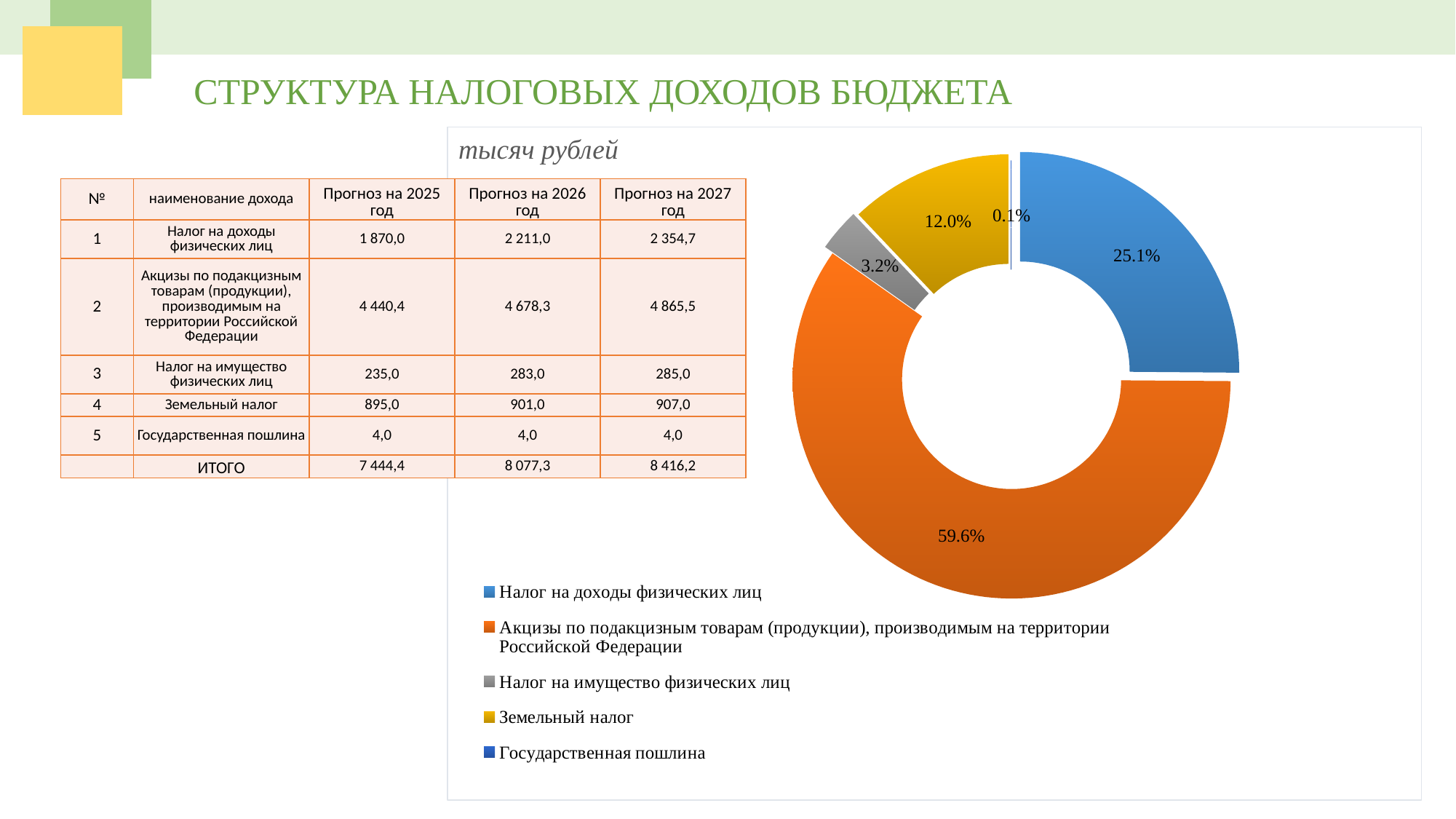
Which category has the smallest share in the doughnut chart? Государственная пошлина In the doughnut chart, what is the difference in percentage points between the share of "Акцизы по подакцизным товарам" and "Налог на доходы физических лиц"? 34.5 percentage points What share of the doughnut chart does "Государственная пошлина" have? 0.1% What share of the doughnut chart does "Акцизы по подакцизным товарам (продукции), производимым на территории Российской Федерации" have? 59.6% What kind of chart is shown on the slide? Doughnut (pie) chart In the doughnut chart, which is larger: the share of "Земельный налог" or "Налог на имущество физических лиц"? Земельный налог Which category has the largest share in the doughnut chart? Акцизы по подакцизным товарам (продукции), производимым на территории Российской Федерации What share of the doughnut chart does "Земельный налог" have? 12.0% How many categories does the legend of the doughnut chart list? 5 What share of the doughnut chart does "Налог на доходы физических лиц" have? 25.1% What share of the doughnut chart does "Налог на имущество физических лиц" have? 3.2% What colour is the slice for "Земельный налог" in the doughnut chart? Yellow